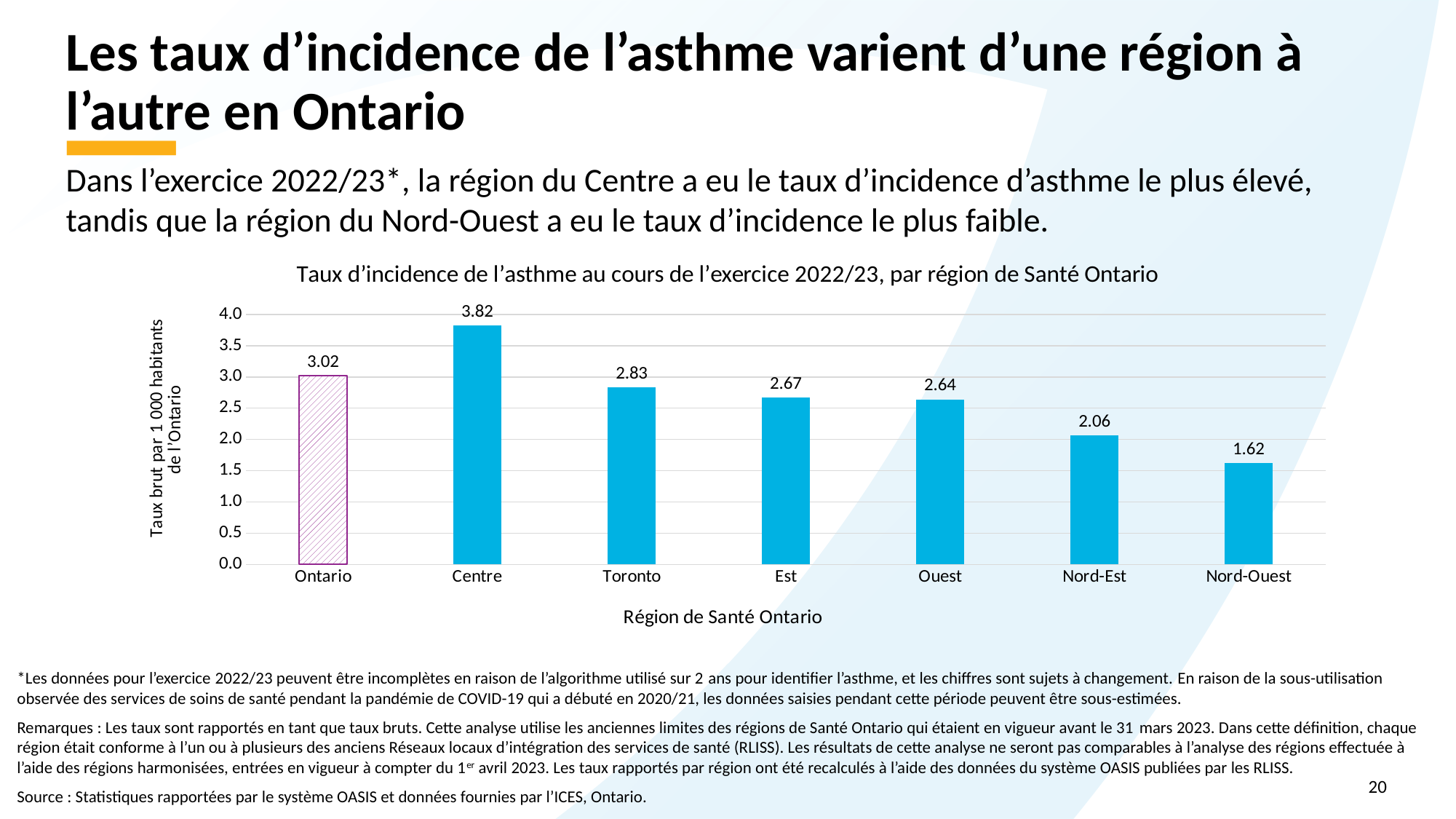
What is the label of the x axis? Région de Santé Ontario What kind of chart is shown on the slide? bar chart What is the value shown for Nord-Est? 2.06 Which is larger, the value for Toronto or the value for Ouest? Toronto How many bars are shown in the chart? 7 What is the asthma incidence rate for Centre? 3.82 Is the value for Nord-Est greater or less than 2.5? less Which region has the highest incidence rate? Centre What is the difference between the values for Centre and Nord-Ouest? 2.20 What is the value shown for Ontario? 3.02 Which region has the lowest incidence rate? Nord-Ouest What is the difference between the values for Toronto and Est? 0.16